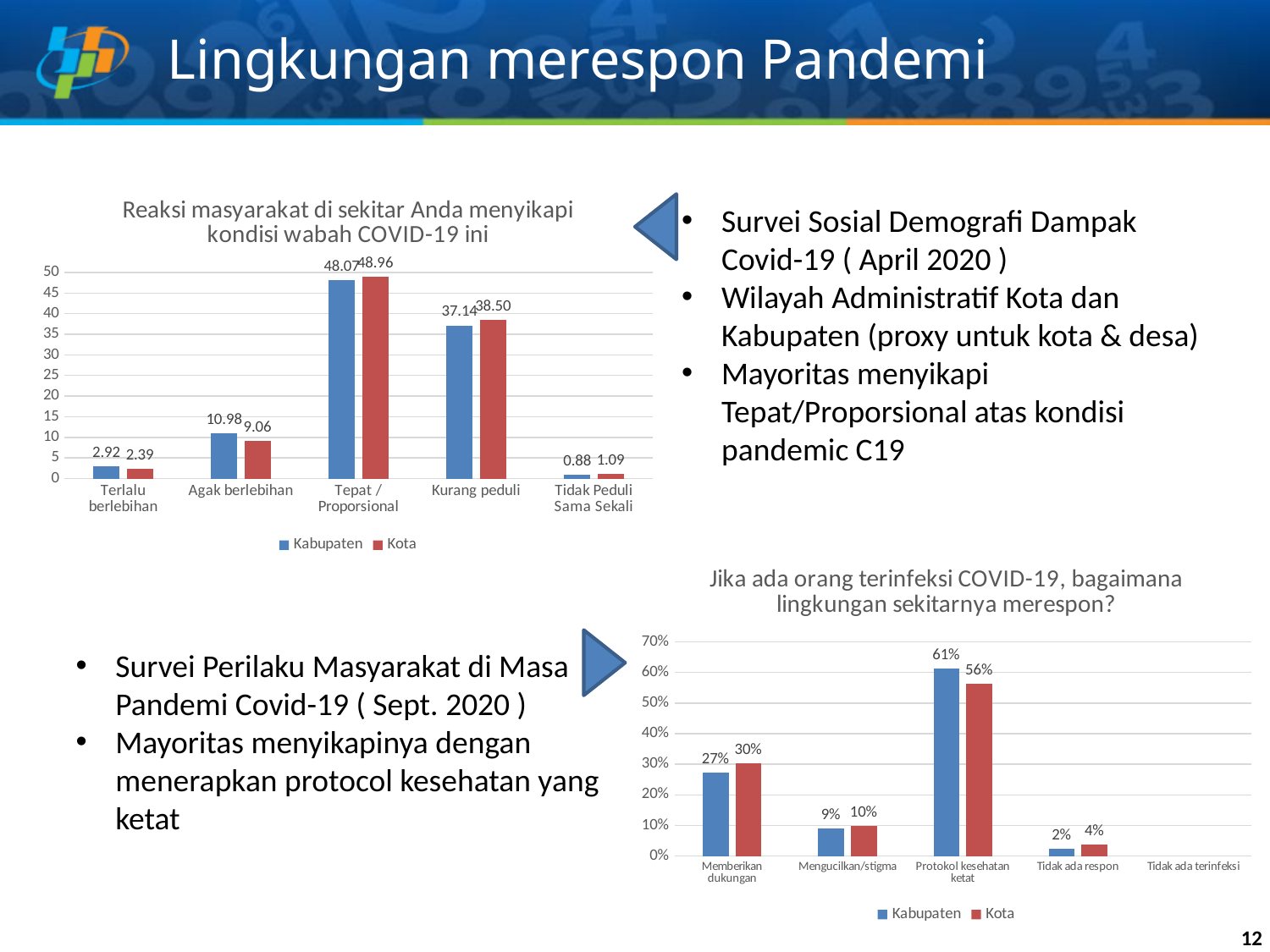
What kind of chart is the chart titled "Reaksi masyarakat di sekitar Anda menyikapi kondisi wabah COVID-19 ini"? Bar chart In the chart titled "Jika ada orang terinfeksi COVID-19, bagaimana lingkungan sekitarnya merespon?", how many categories are shown on the x axis? 5 In the chart titled "Reaksi masyarakat di sekitar Anda menyikapi kondisi wabah COVID-19 ini", which is larger for Terlalu berlebihan: Kabupaten or Kota? Kabupaten In the chart titled "Reaksi masyarakat di sekitar Anda menyikapi kondisi wabah COVID-19 ini", what is the Kota value for Kurang peduli? 38.50 In the chart titled "Reaksi masyarakat di sekitar Anda menyikapi kondisi wabah COVID-19 ini", how many series does the legend list? 2 In the chart titled "Reaksi masyarakat di sekitar Anda menyikapi kondisi wabah COVID-19 ini", which category has the lowest Kabupaten value? Tidak Peduli Sama Sekali In the chart titled "Jika ada orang terinfeksi COVID-19, bagaimana lingkungan sekitarnya merespon?", which category has the highest Kota value? Protokol kesehatan ketat In the chart titled "Jika ada orang terinfeksi COVID-19, bagaimana lingkungan sekitarnya merespon?", what is the Kabupaten value for Protokol kesehatan ketat? 61% In the chart titled "Jika ada orang terinfeksi COVID-19, bagaimana lingkungan sekitarnya merespon?", what is the difference between the Kabupaten and Kota values for Protokol kesehatan ketat? 5% In the chart titled "Jika ada orang terinfeksi COVID-19, bagaimana lingkungan sekitarnya merespon?", what is the Kota value for Memberikan dukungan? 30% In the chart titled "Reaksi masyarakat di sekitar Anda menyikapi kondisi wabah COVID-19 ini", what is the difference between the Kabupaten and Kota values for Agak berlebihan? 1.92 In the chart titled "Reaksi masyarakat di sekitar Anda menyikapi kondisi wabah COVID-19 ini", what is the Kabupaten value for Tepat / Proporsional? 48.07